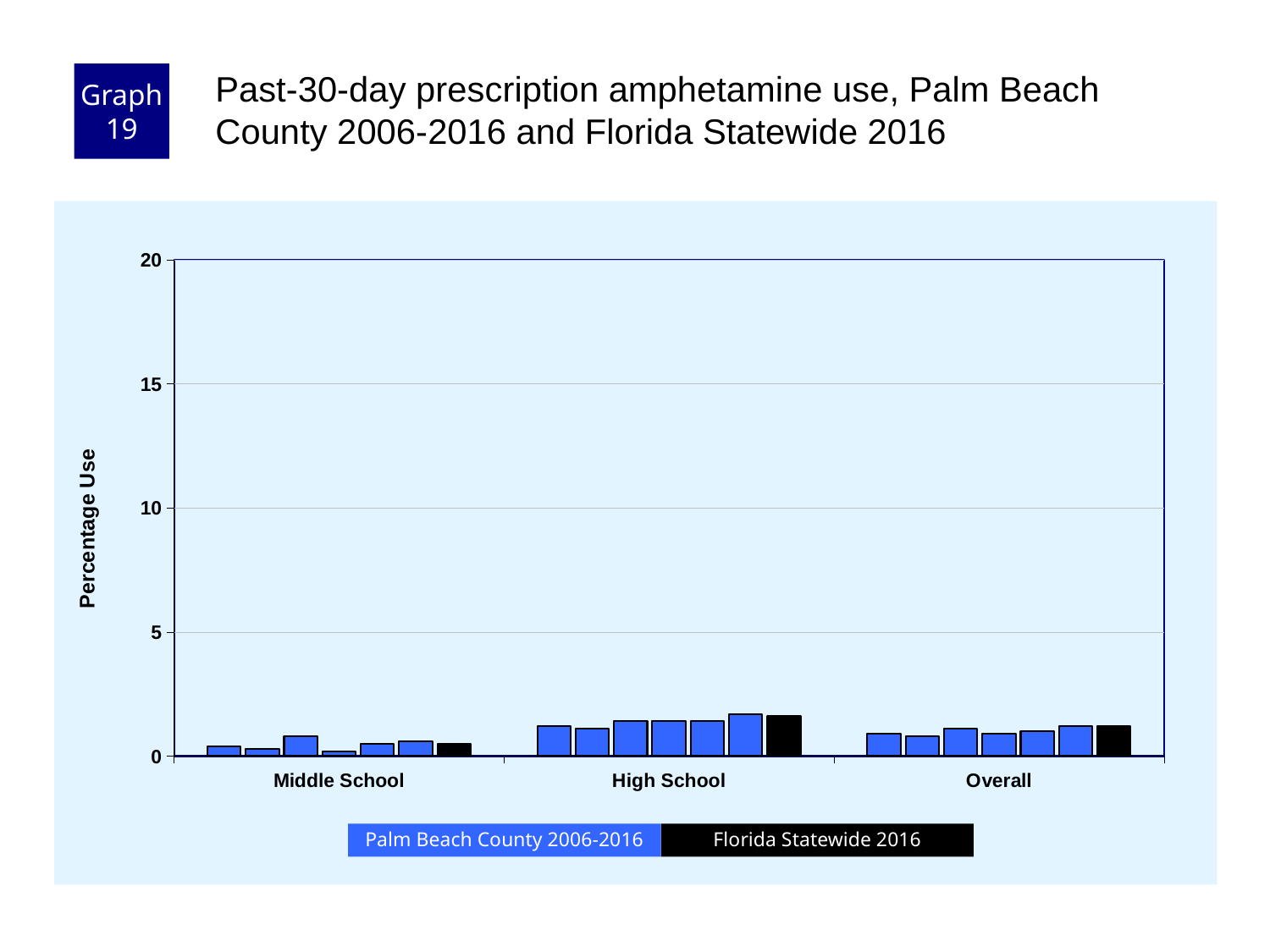
Which is larger, the Florida Statewide 2016 value for High School or for Middle School? High School What is the label on the y axis? Percentage Use Which category has the lowest bars overall? Middle School Which is larger, the Florida Statewide 2016 value for Overall or for Middle School? Overall Is the Florida Statewide 2016 value for Overall greater or less than 10? less How many series does the legend list? 2 Is the Florida Statewide 2016 value for Middle School greater or less than 5? less How many categories are shown on the x axis? 3 Is the Florida Statewide 2016 value for High School greater or less than 5? less Which colour represents Florida Statewide 2016 in the legend? black Which category has the highest bars overall? High School What kind of chart is shown on the slide? bar chart